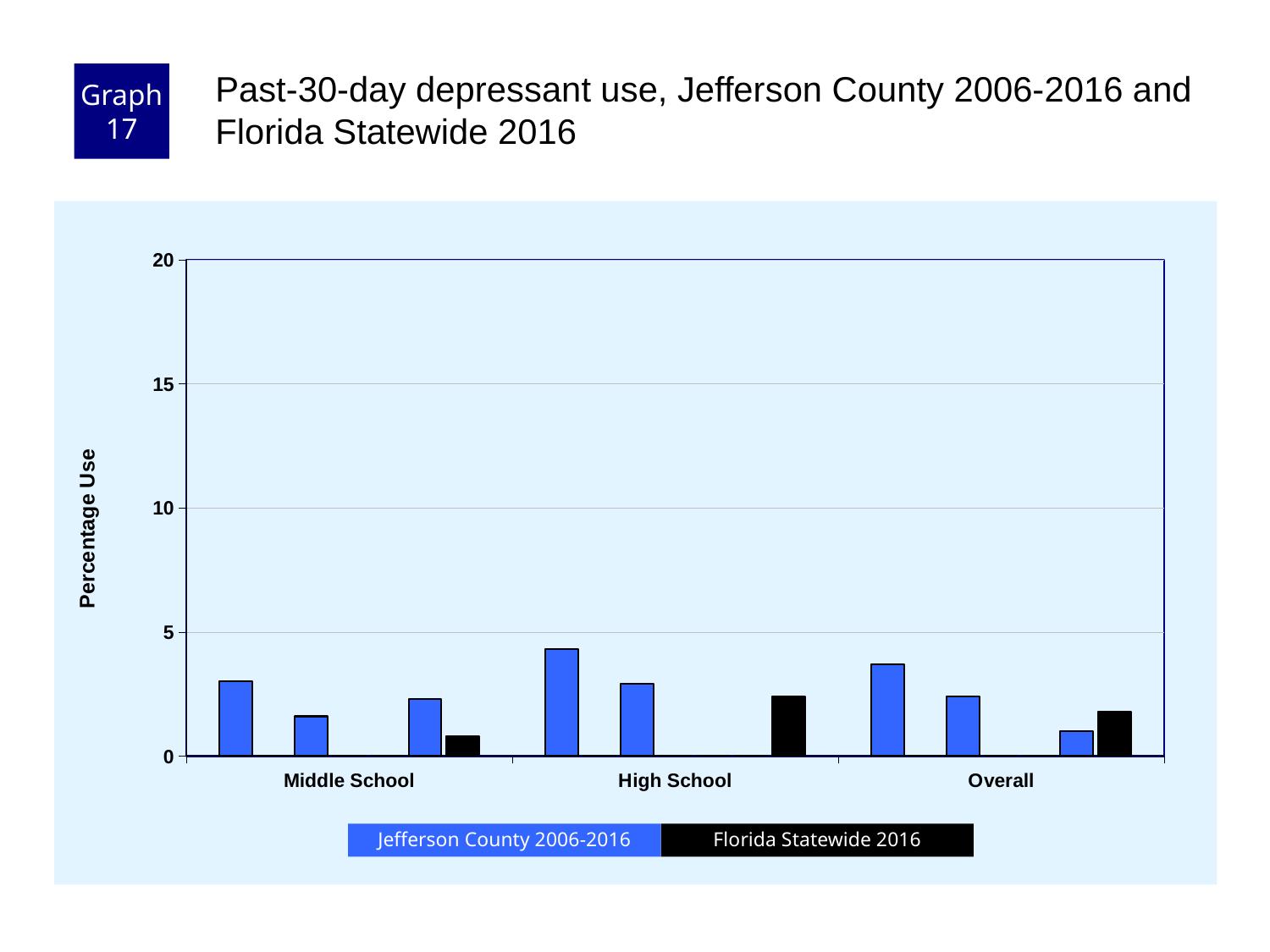
How many school-level categories are shown on the x axis? 3 What is the highest value shown on the y axis? 20 What is the title of the y axis? Percentage Use Among the three categories, which has the highest Florida Statewide 2016 value? High School Is the Florida Statewide 2016 value for High School larger or smaller than the Florida Statewide 2016 value for Middle School? larger Is the Florida Statewide 2016 value for Middle School greater or less than 5? less How many series does the legend list? 2 What kind of chart is shown on the slide? bar chart Among the three categories, which has the lowest Florida Statewide 2016 value? Middle School Is the Florida Statewide 2016 value for Overall greater or less than 5? less Is the tallest bar on the chart greater or less than 5? less